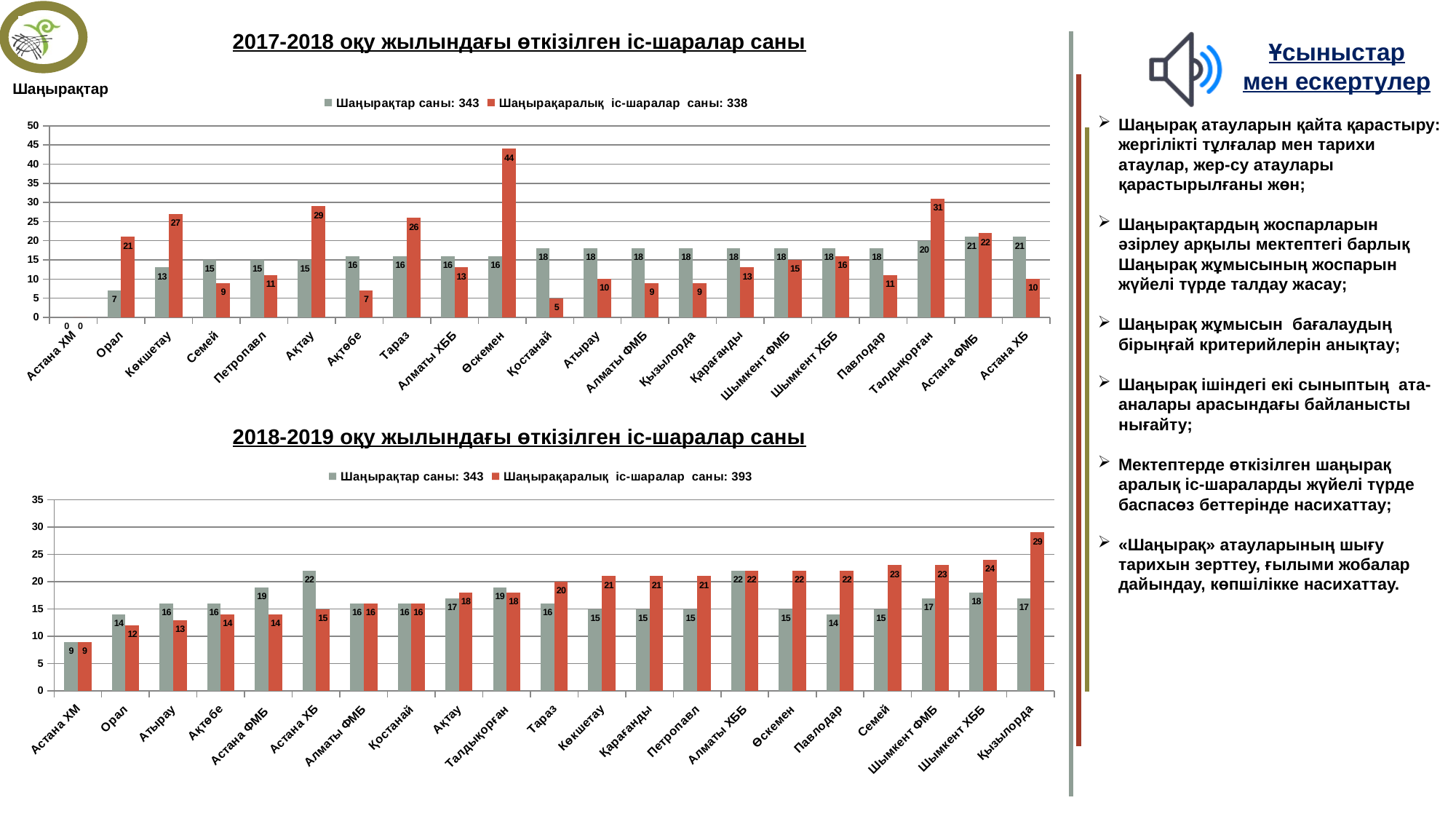
In the 2017-2018 chart, which category has the lowest non-zero value for the red series? Қостанай In the 2017-2018 chart, which category has the highest value for the red series (Шаңырақаралық іс-шаралар саны)? Өскемен How many series does the legend of the 2017-2018 chart list? 2 In the 2018-2019 chart, which category has the highest value for the red series? Қызылорда What type of chart is the 2018-2019 chart? bar chart In the 2018-2019 chart, which is larger for Астана ХБ: the grey value or the red value? the grey value (22) How many categories are shown on the x axis of the 2018-2019 chart? 21 In the 2018-2019 chart, what is the value of the grey series for Астана ХМ? 9 In the 2017-2018 chart, what is the difference between the red and grey values for Көкшетау? 14 In the 2017-2018 chart, what is the value of the grey series (Шаңырақтар саны) for Талдықорған? 20 In the 2017-2018 chart, what is the value of the red series (Шаңырақаралық іс-шаралар саны) for Өскемен? 44 In the 2018-2019 chart, what is the value of the red series (Шаңырақаралық іс-шаралар саны) for Қызылорда? 29